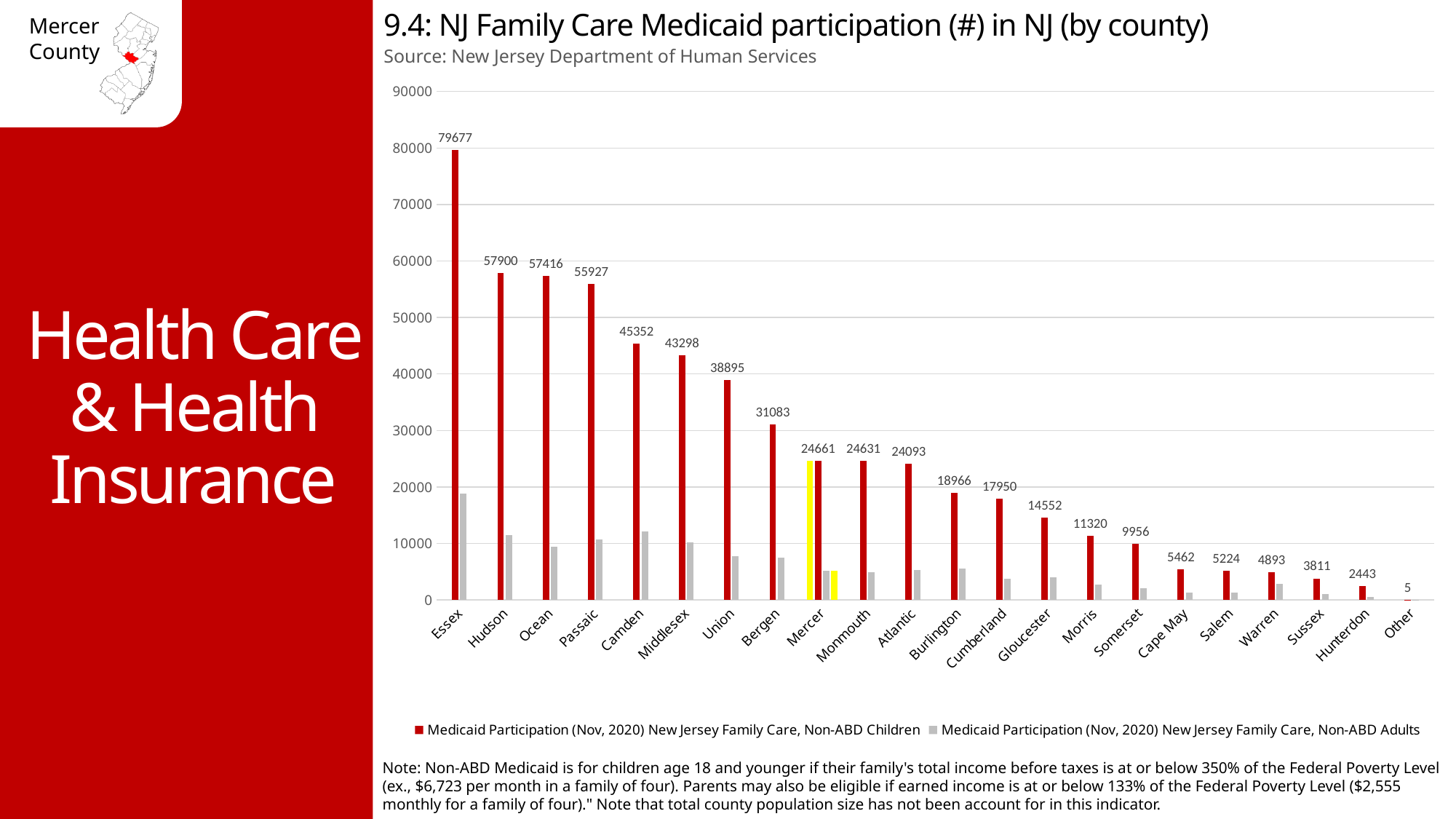
Which category has the lowest Non-ABD Children Medicaid participation? Other Is the Non-ABD Adults value for Essex greater or less than 10000? greater What is the difference between the Non-ABD Children values for Bergen and Mercer? 6422 Which county has the highest Non-ABD Children Medicaid participation? Essex How many series does the legend list? 2 What is the Non-ABD Children Medicaid participation value for Mercer? 24661 What is the Non-ABD Children Medicaid participation value for Gloucester? 14552 Is the Non-ABD Adults value for Mercer greater or less than 10000? less What is the Non-ABD Children Medicaid participation value for Essex? 79677 How many categories are shown on the x axis? 22 What is the difference between the Non-ABD Children values for Essex and Hudson? 21777 Which has a larger Non-ABD Children value, Camden or Middlesex? Camden